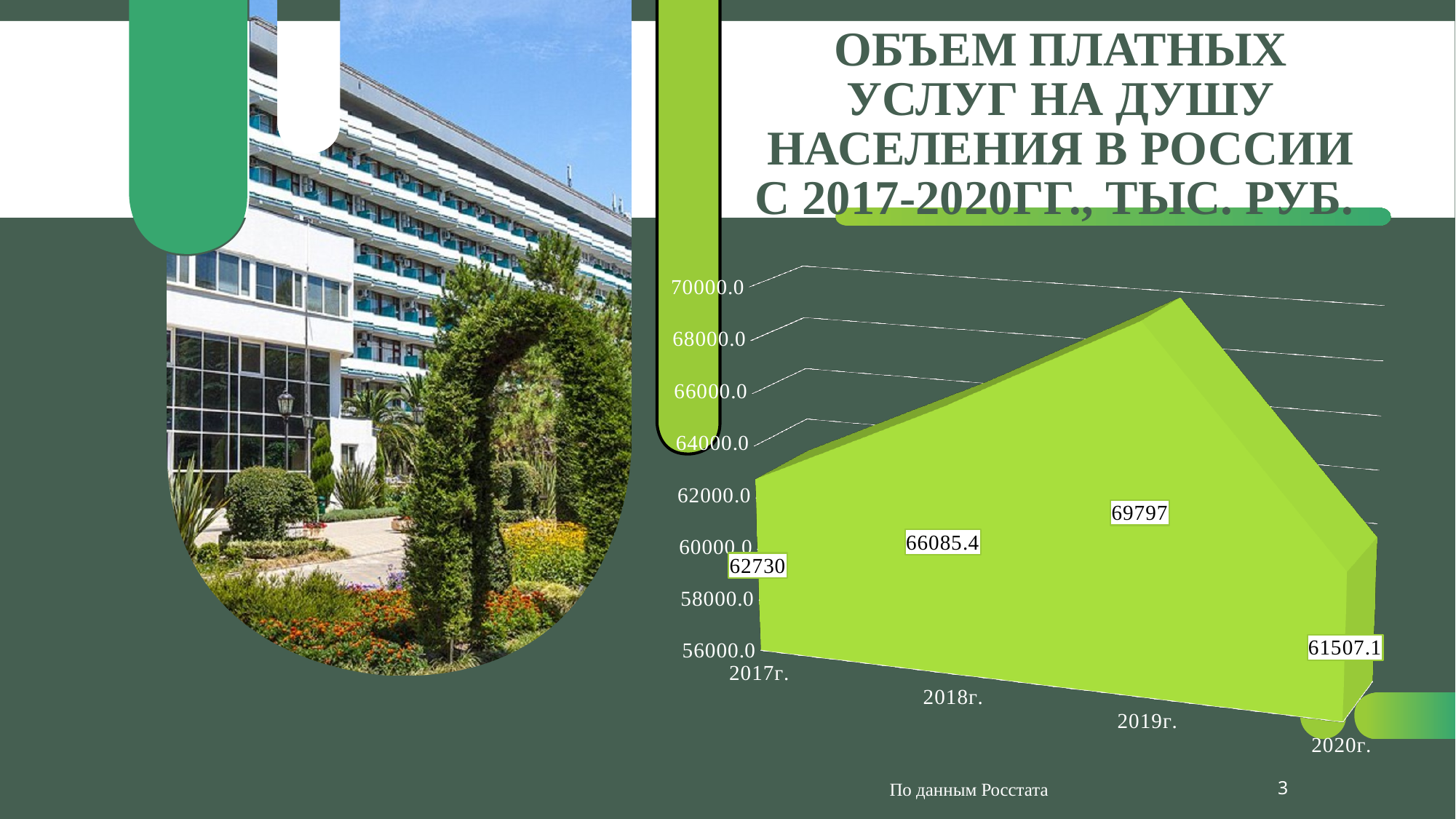
What is the value for 2019г.? 69797 What is the difference between the values for 2019г. and 2018г.? 3711.6 Which year has the highest value? 2019г. Which year has the lowest value? 2020г. What is the value for 2020г.? 61507.1 Does the value rise or fall from 2019г. to 2020г.? fall What kind of chart is shown on the slide? area chart What is the difference between the values for 2017г. and 2020г.? 1222.9 Which is larger, the value for 2018г. or the value for 2017г.? 2018г. How many years are plotted on the chart? 4 What is the value for 2018г.? 66085.4 What is the value for 2017г.? 62730